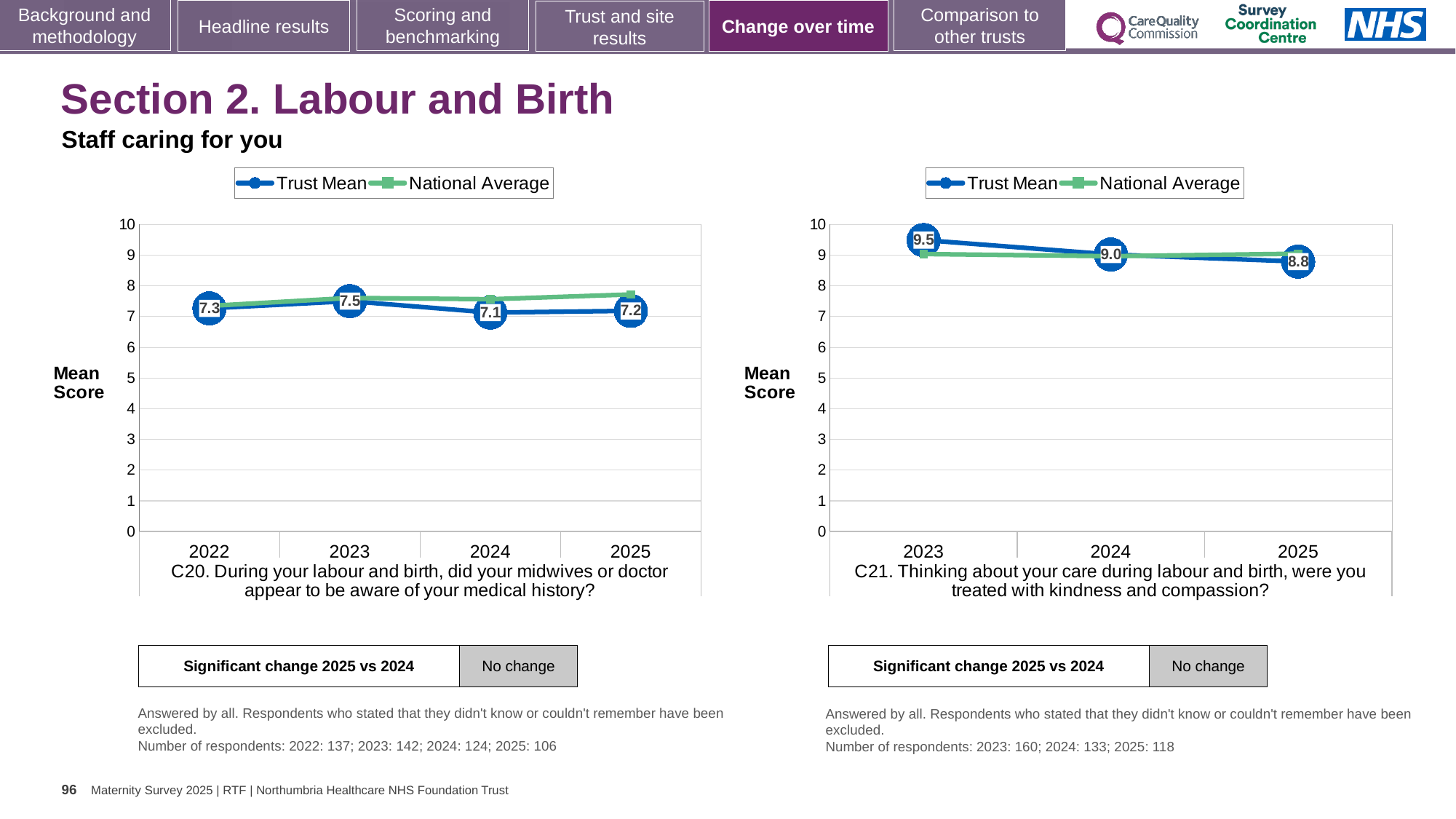
In the C20 chart (left), which year has the lowest Trust Mean score? 2024 In the C20 chart (left), is the National Average value for 2025 greater or less than 7? greater In the C20 chart (left), what is the difference between the Trust Mean scores for 2023 and 2024? 0.4 In the C21 chart (right), what is the difference between the Trust Mean scores for 2023 and 2025? 0.7 What kind of chart is the C20 chart (left)? line chart In the C21 chart (right), what is the Trust Mean score for 2025? 8.8 In the C21 chart (right), which year has the highest Trust Mean score? 2023 In the C21 chart (right), is the National Average value for 2023 greater or less than 8? greater In the C20 chart (left), what is the Trust Mean score for 2023? 7.5 In the C20 chart (left), how many years are plotted on the x axis? 4 In the C21 chart (right), does the Trust Mean rise or fall from 2023 to 2025? fall How many series does the legend of the C21 chart (right) list? 2